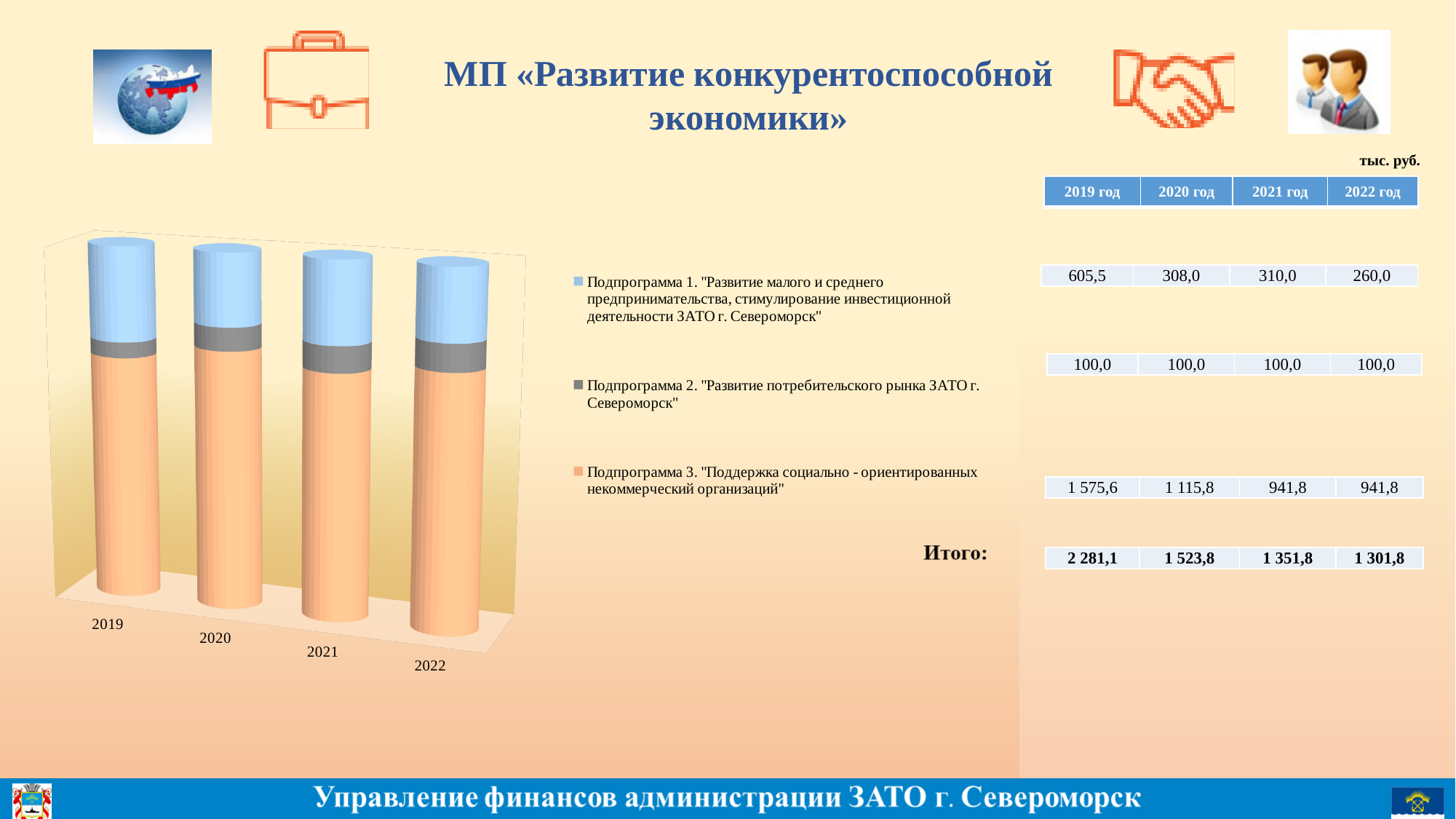
What is the difference between the Подпрограмма 3 values for 2019 год and 2021 год? 633,8 What is the total (Итого) for 2022 год? 1 301,8 What is the value for Подпрограмма 2 in 2022 год? 100,0 How many series does the chart legend list? 3 What is the value for Подпрограмма 3 in 2020 год? 1 115,8 Which colour represents Подпрограмма 3 in the chart? Orange (peach) In which year is the total (Итого) the highest? 2019 год What is the total (Итого) for 2019 год? 2 281,1 How many years (categories) are shown on the x axis of the chart? 4 In which year is the value for Подпрограмма 1 the lowest? 2022 год What is the value for Подпрограмма 1 in 2019 год? 605,5 What kind of chart is shown on the slide? Stacked bar chart